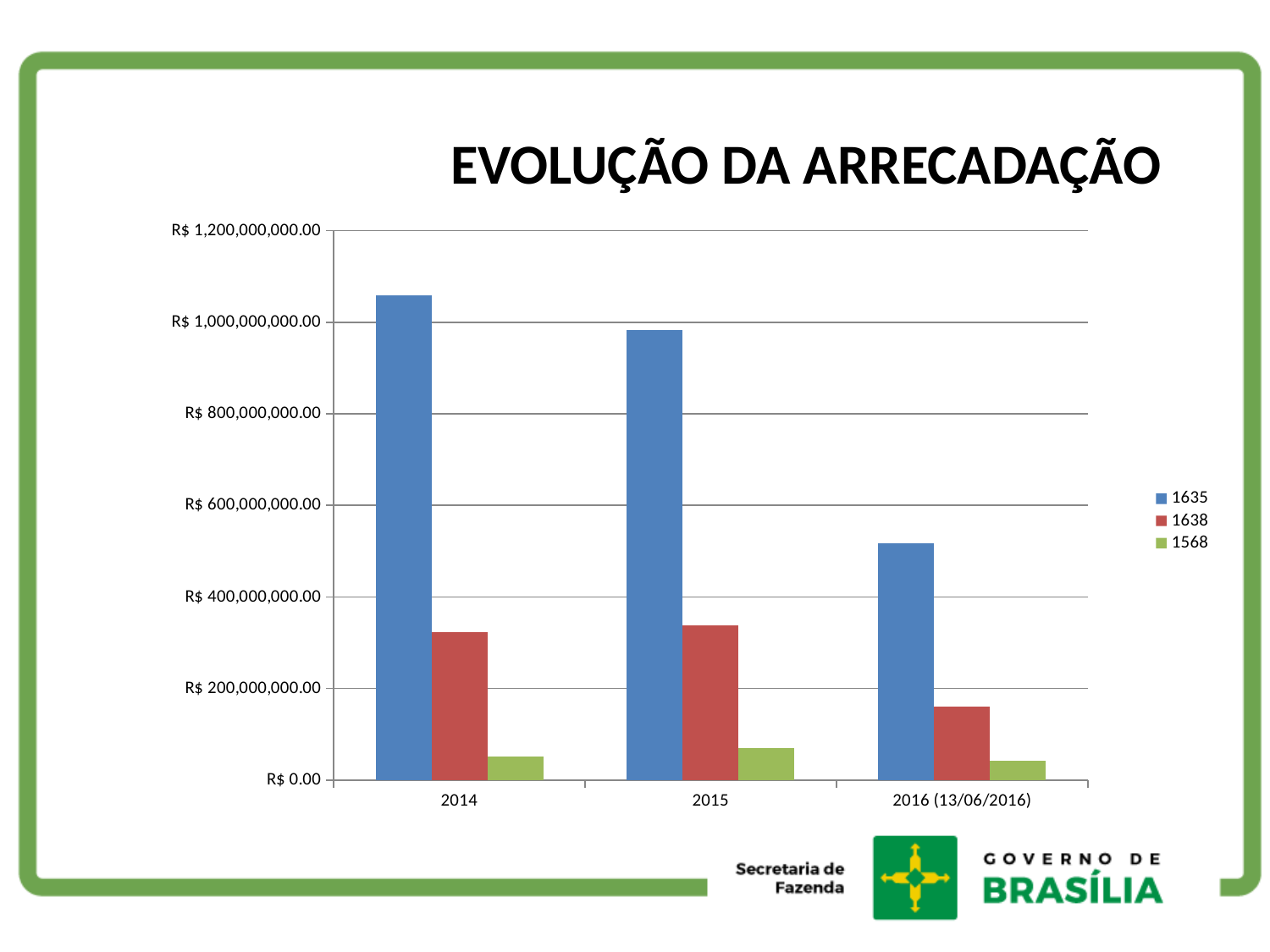
In 2014, which series has the larger value, 1635 or 1638? 1635 Is the value for series 1638 in 2016 (13/06/2016) greater or less than R$ 200,000,000.00? less How many series does the legend list? 3 What kind of chart is shown on the slide? bar chart Is the value for series 1635 in 2016 (13/06/2016) greater or less than R$ 400,000,000.00? greater In which category is the value for series 1635 lowest? 2016 (13/06/2016) Does the value for series 1635 rise or fall from 2014 to 2016 (13/06/2016)? fall What is the title of the chart? EVOLUÇÃO DA ARRECADAÇÃO Which series is shown in blue in the legend? 1635 In which year is the value for series 1635 highest? 2014 Is the value for series 1635 in 2014 greater or less than R$ 1,000,000,000.00? greater How many categories are shown on the x axis? 3